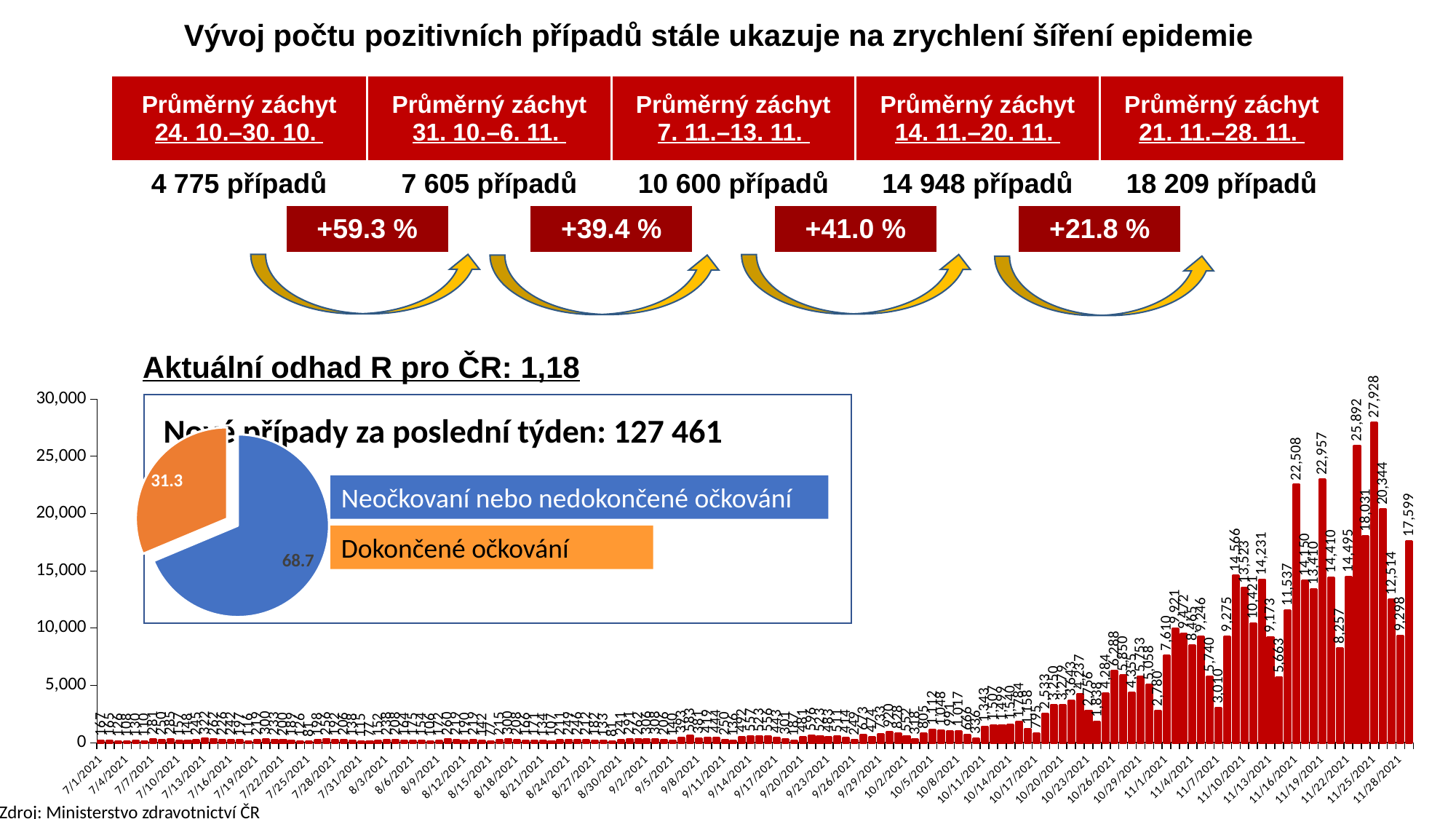
In the bar chart of daily cases, is the rightmost bar greater or less than 20,000? less In the bar chart of daily cases, which is larger: the bar labelled 22,957 or the bar labelled 22,508? 22,957 In the bar chart of daily cases, what is the value of the highest bar? 27,928 In the bar chart of daily cases, is the highest bar greater or less than 25,000? greater What kind of chart is the large chart at the bottom of the slide showing daily case counts? bar chart In the bar chart of daily cases, what is the difference between the two highest bars, labelled 27,928 and 25,892? 2,036 In the bar chart of daily cases, do the values generally rise or fall from July to late November 2021? rise In the pie chart, which slice is larger: 'Neočkovaní nebo nedokončené očkování' or 'Dokončené očkování'? Neočkovaní nebo nedokončené očkování In the bar chart of daily cases, what is the value of the rightmost (last) bar? 17,599 In the pie chart, what share is shown for 'Dokončené očkování'? 31.3 How many entries does the legend of the pie chart list? 2 What kind of chart is the small chart inside the box labelled 'Nové případy za poslední týden: 127 461'? pie chart